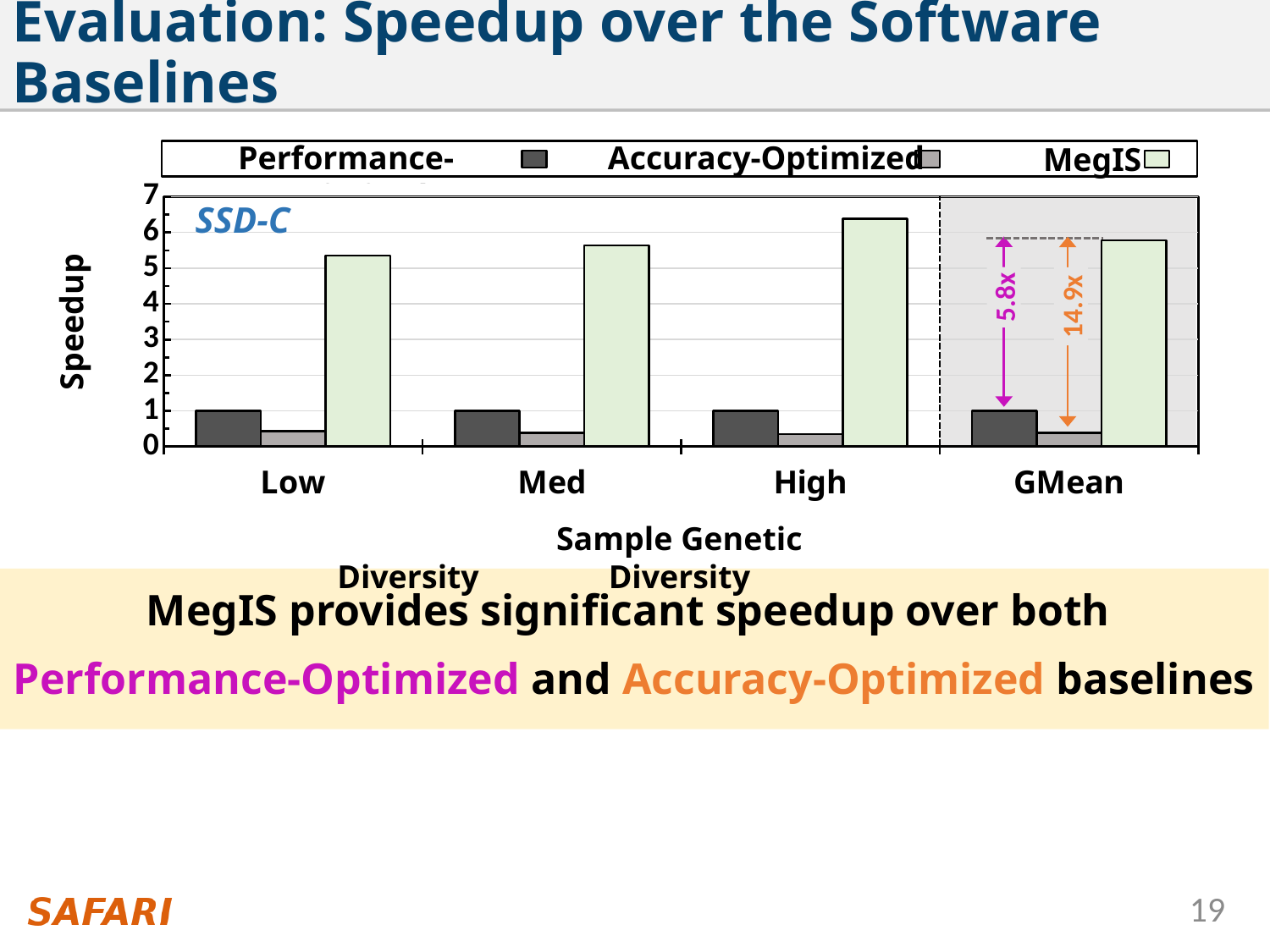
How many series does the legend list? 3 According to the annotation, what is MegIS's geometric-mean speedup over the Accuracy-Optimized baseline? 14.9x Do the MegIS bars rise or fall going from Low to Med to High? rise For the Low category, which is larger: the MegIS bar or the Performance-Optimized bar? MegIS What kind of chart is shown on the slide? bar chart Is the Accuracy-Optimized value for Med greater or less than 1? less How many categories are shown along the x axis? 4 Is the MegIS value for Low greater or less than 5? greater What label is written on the y axis of the chart? Speedup According to the annotation, what is MegIS's geometric-mean speedup over the Performance-Optimized baseline? 5.8x Is the MegIS value for High greater or less than 6? greater For which sample genetic diversity category is the MegIS bar the highest? High